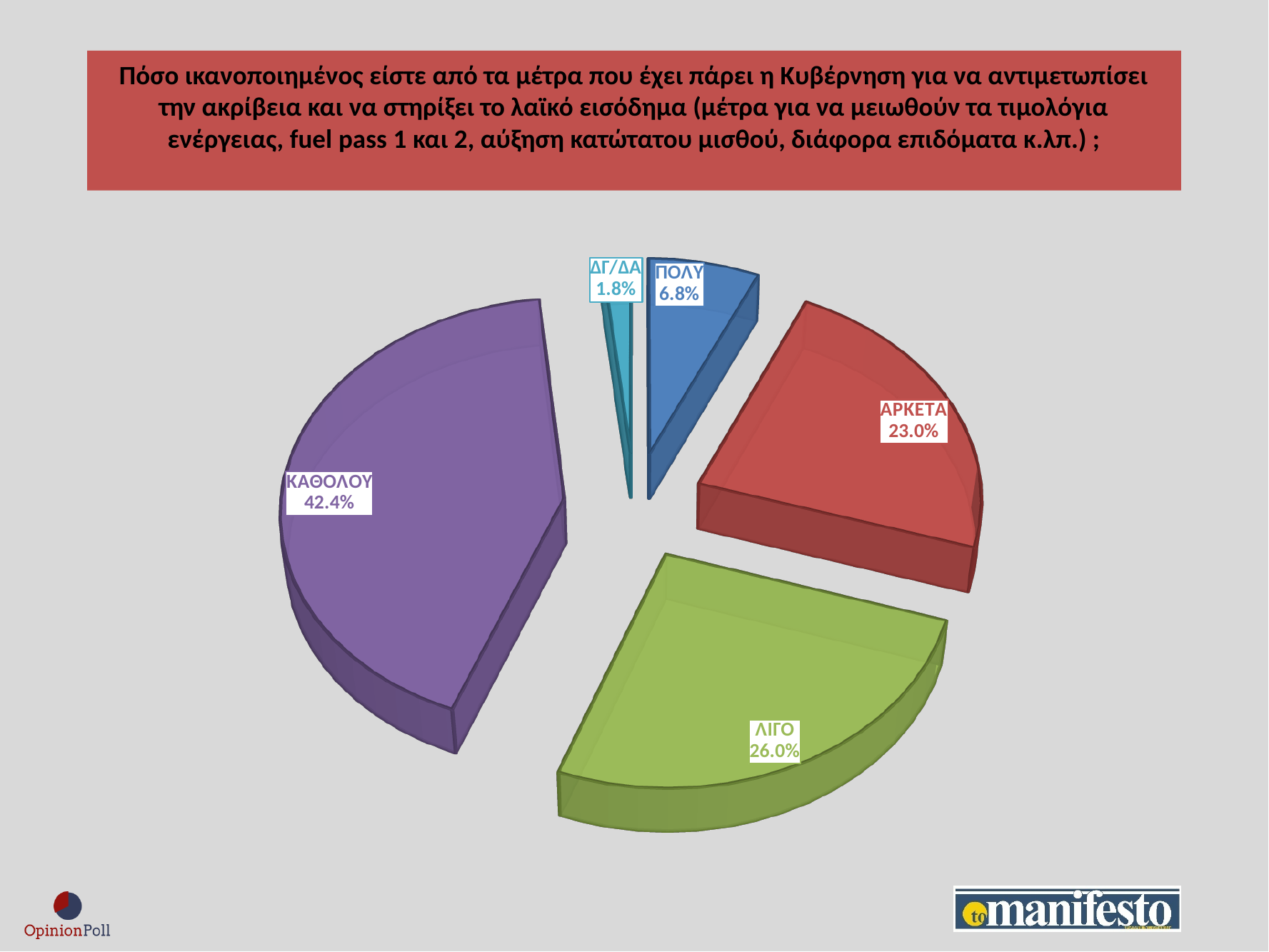
What percentage of respondents answered ΔΓ/ΔΑ? 1.8% What percentage of respondents answered ΛΙΓΟ? 26.0% What percentage of respondents answered ΚΑΘΟΛΟΥ? 42.4% What colour is the ΚΑΘΟΛΟΥ slice? Purple What percentage of respondents answered ΠΟΛΥ? 6.8% Which is larger, the share for ΑΡΚΕΤΑ or the share for ΠΟΛΥ? ΑΡΚΕΤΑ How many slices does the pie chart have? 5 What type of chart is shown on the slide? Pie chart What percentage of respondents answered ΑΡΚΕΤΑ? 23.0% Which response category has the largest share of the pie? ΚΑΘΟΛΟΥ Which response category has the smallest share of the pie? ΔΓ/ΔΑ What is the difference in percentage points between ΚΑΘΟΛΟΥ and ΛΙΓΟ? 16.4